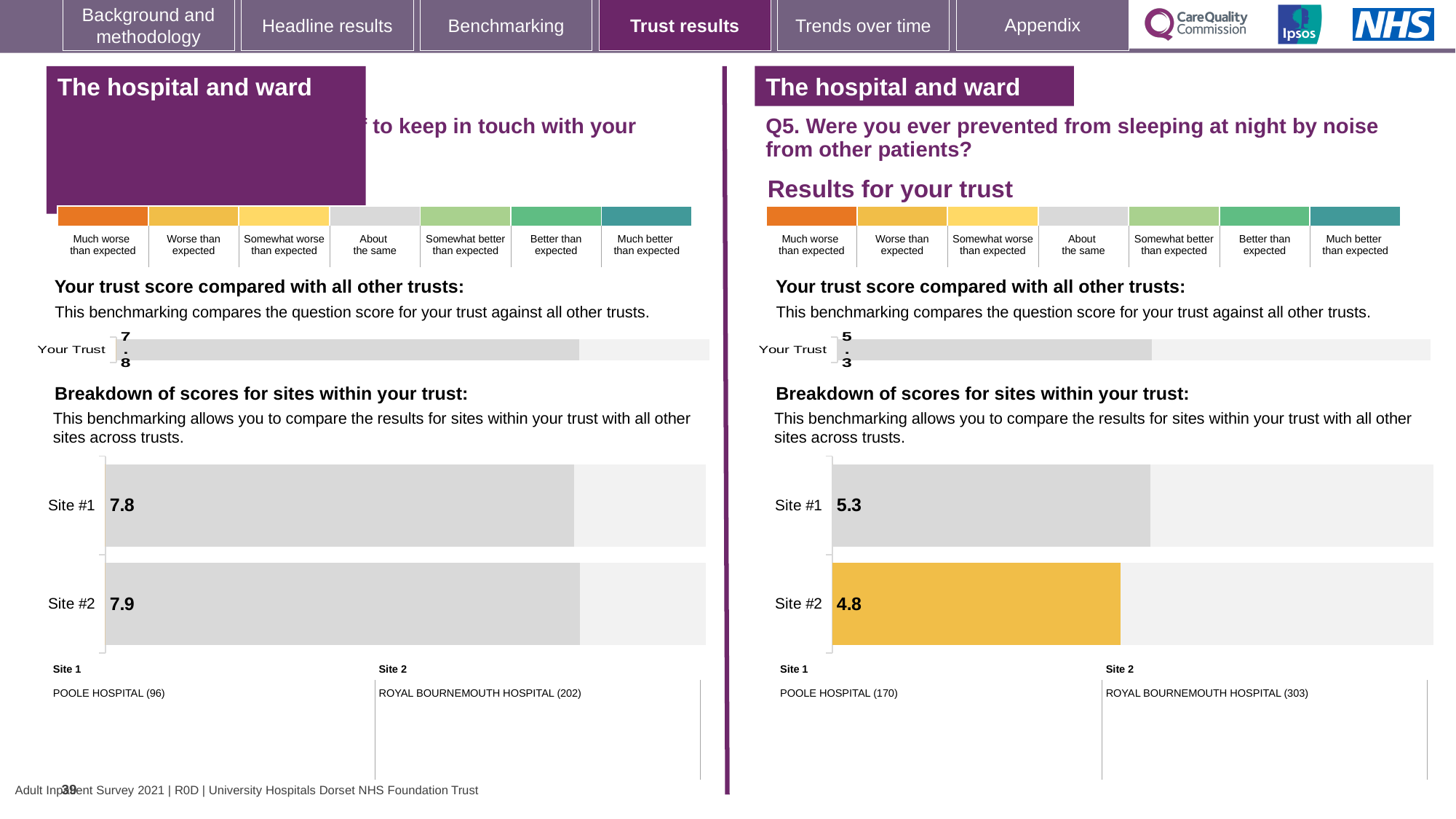
On the right-hand (Q5) 'Your trust score compared with all other trusts' chart, what is the score for Your Trust? 5.3 On the left-hand 'Breakdown of scores for sites within your trust' chart, what is the score for Site #1? 7.8 On the left-hand site breakdown chart, which site has the lower score? Site #1 On the right-hand (Q5) site breakdown chart, what is the difference between the Site #1 and Site #2 scores? 0.5 On the right-hand (Q5) 'Breakdown of scores for sites within your trust' chart, what is the score for Site #2? 4.8 What type of chart is used for the site breakdown on the right-hand (Q5) side of the slide? Bar chart On the right-hand (Q5) 'Breakdown of scores for sites within your trust' chart, what is the score for Site #1? 5.3 On the left-hand 'Your trust score compared with all other trusts' chart, what is the score for Your Trust? 7.8 On the left-hand 'Breakdown of scores for sites within your trust' chart, what is the score for Site #2? 7.9 On the left-hand site breakdown chart, what is the difference between the Site #2 and Site #1 scores? 0.1 How many sites are shown on the right-hand (Q5) site breakdown chart? 2 On the right-hand (Q5) site breakdown chart, which site has the higher score? Site #1